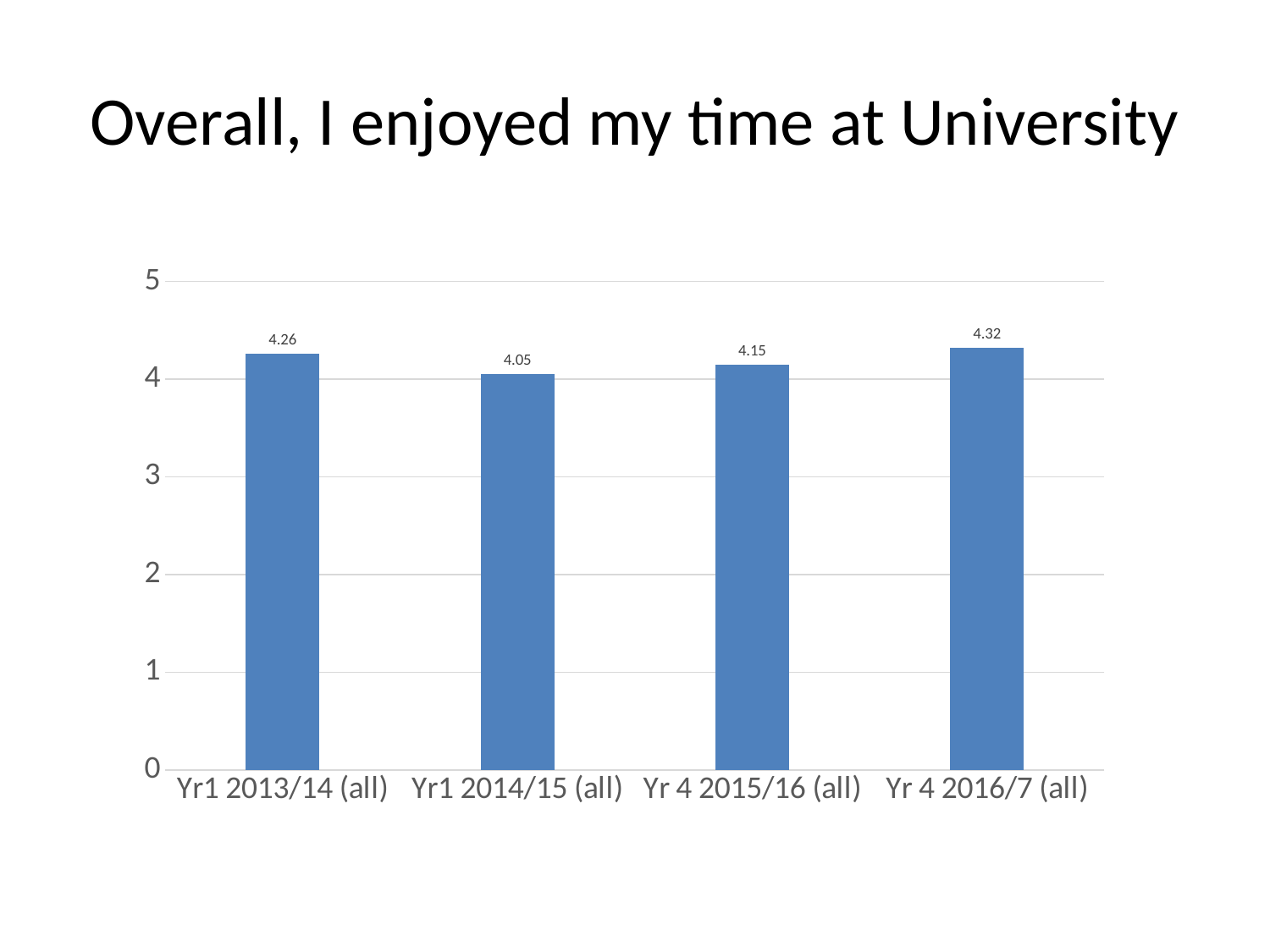
What is the difference between the values for Yr 4 2016/7 (all) and Yr1 2014/15 (all)? 0.27 Is the value for Yr1 2014/15 (all) greater or less than 3? greater Which is larger, the value for Yr1 2013/14 (all) or Yr 4 2015/16 (all)? Yr1 2013/14 (all) What is the value for Yr 4 2015/16 (all)? 4.15 What is the title of the slide? Overall, I enjoyed my time at University Which category has the lowest value? Yr1 2014/15 (all) How many categories are shown on the x axis? 4 Which category has the highest value? Yr 4 2016/7 (all) What is the value for Yr1 2014/15 (all)? 4.05 What is the value for Yr1 2013/14 (all)? 4.26 What is the value for Yr 4 2016/7 (all)? 4.32 What kind of chart is shown on the slide? bar chart